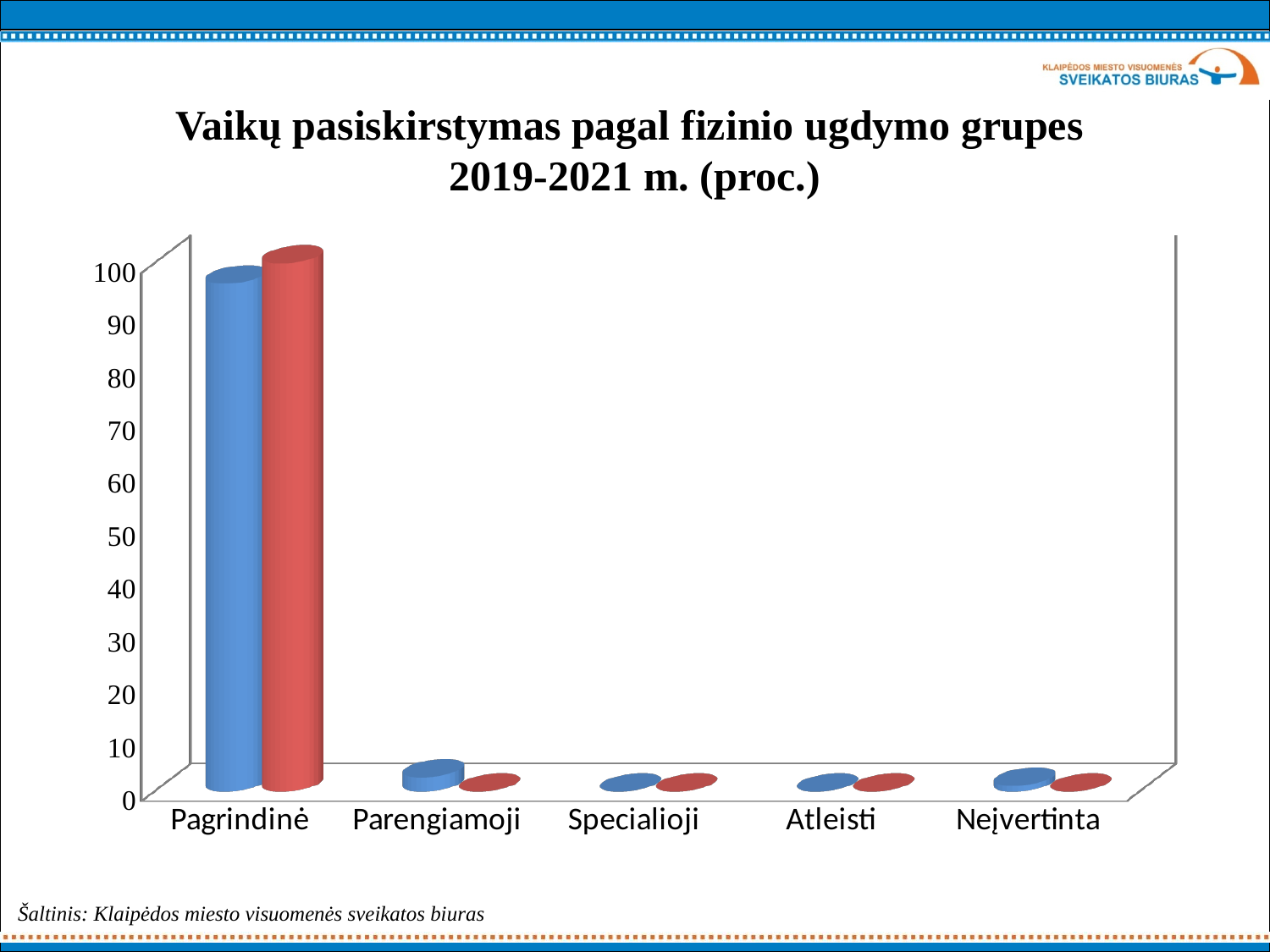
What type of chart is shown on the slide? bar chart Is the value of the red bar for Specialioji greater or less than 10? less Is the value of the blue bar for Parengiamoji greater or less than 10? less Is the value of the red bar for Pagrindinė greater or less than 90? greater Which category has the larger red bar, Parengiamoji or Pagrindinė? Pagrindinė Which category has the highest values in the chart? Pagrindinė What is the highest value shown on the vertical axis of the chart? 100 What is the title of the chart? Vaikų pasiskirstymas pagal fizinio ugdymo grupes 2019-2021 m. (proc.) Which category has the larger blue bar, Pagrindinė or Neįvertinta? Pagrindinė How many categories are shown on the x axis of the chart? 5